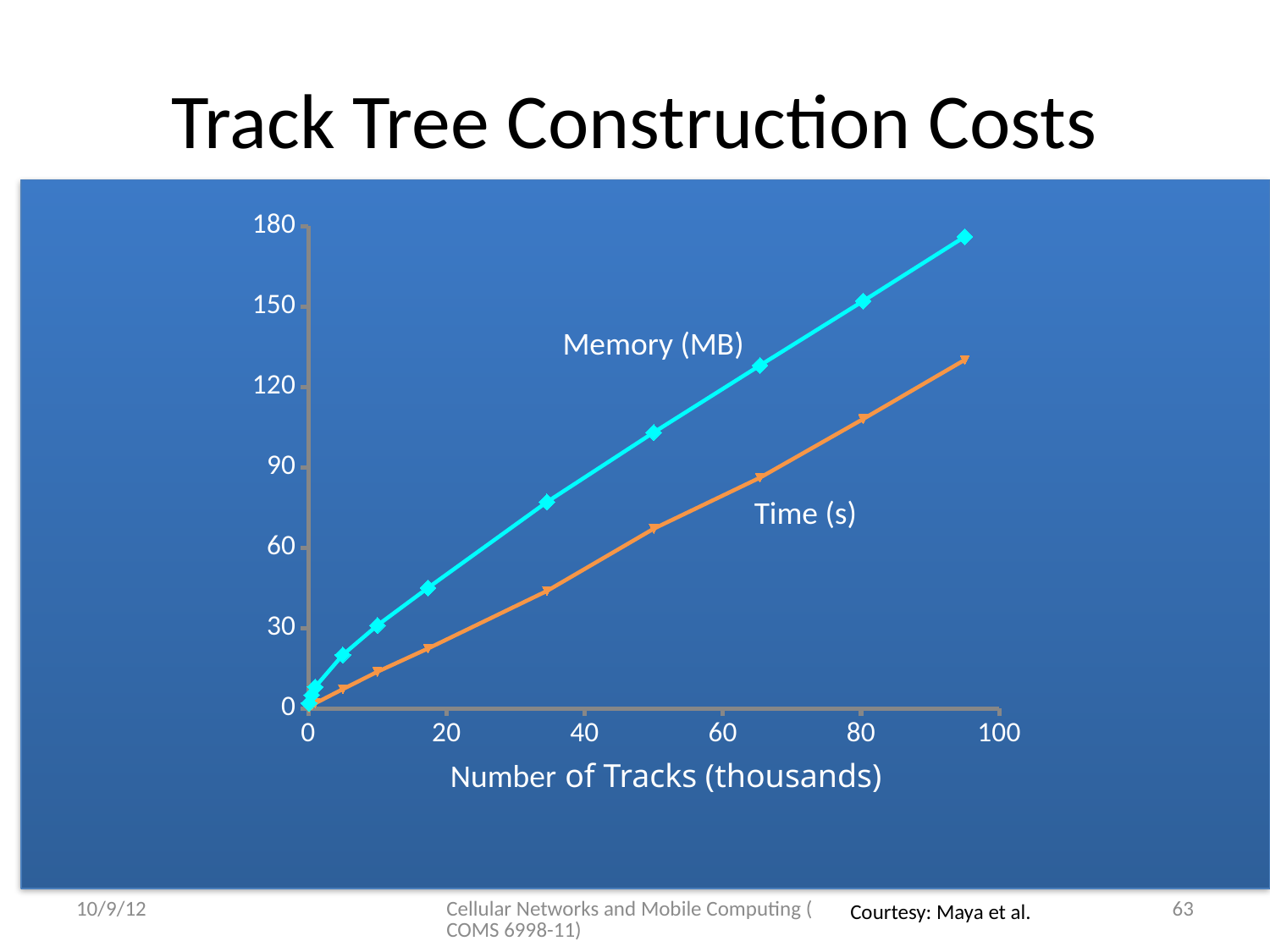
Does the Time (s) series rise or fall as the number of tracks increases? rise What are the names of the two series plotted on the chart? Memory (MB) and Time (s) Which series reaches the highest value on the chart? Memory (MB) What is the label of the x axis? Number of Tracks (thousands) What kind of chart is shown on the slide? line chart Is the value of the Time (s) series at 50 thousand tracks greater or less than 90? less Is the value of the Memory (MB) series at 50 thousand tracks greater or less than 90? greater How many data series are plotted on the chart? 2 Is the value of the Memory (MB) series at its rightmost point greater or less than 150? greater At 80 thousand tracks, which series has the larger value, Memory (MB) or Time (s)? Memory (MB) Does the Memory (MB) series rise or fall as the number of tracks increases? rise